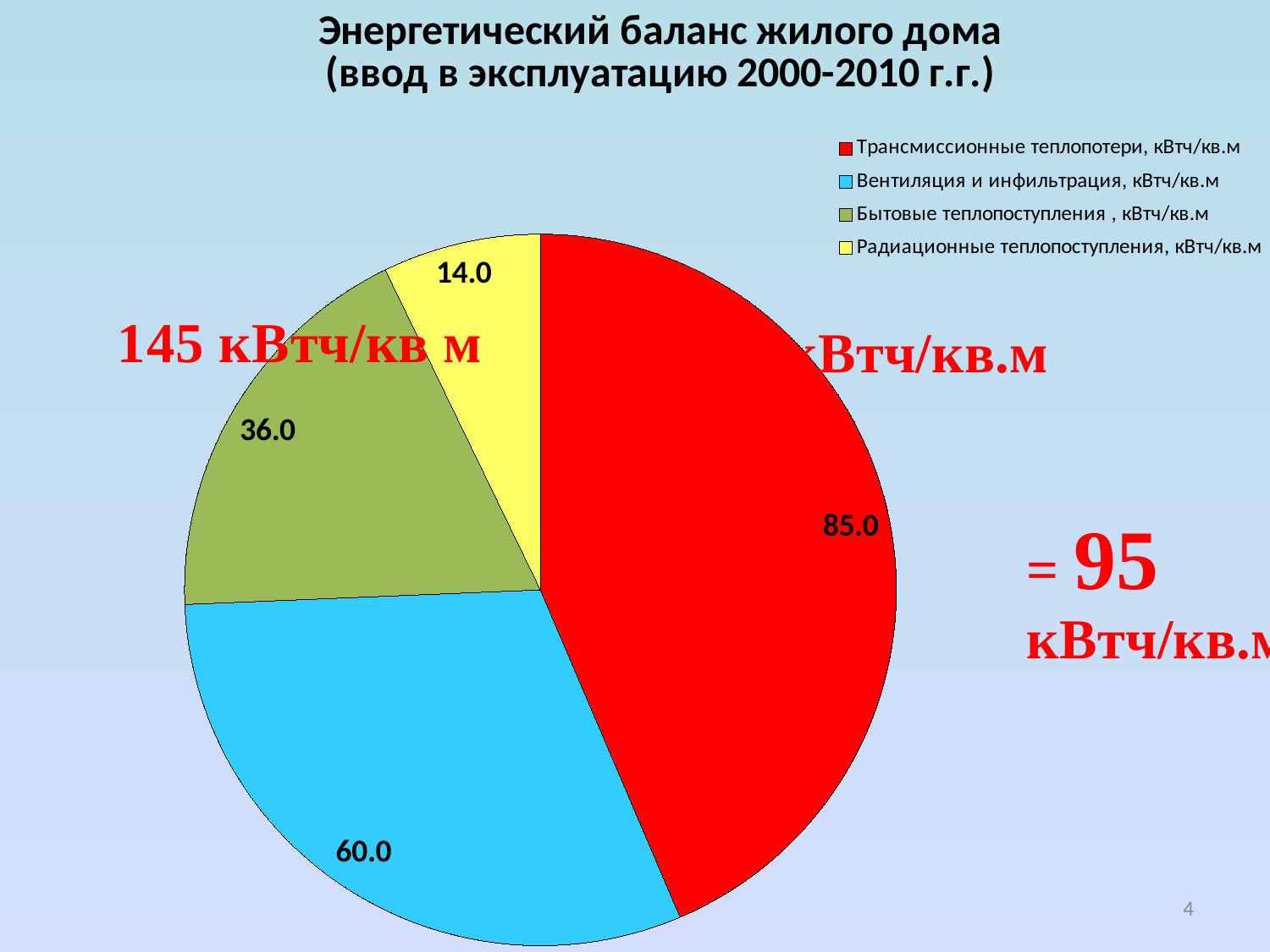
What colour is the slice for Вентиляция и инфильтрация? Blue What is the value for Вентиляция и инфильтрация? 60.0 Which category has the largest slice of the pie? Трансмиссионные теплопотери How many slices does the pie chart have? 4 What is the value for Трансмиссионные теплопотери? 85.0 Which is larger: Бытовые теплопоступления or Радиационные теплопоступления? Бытовые теплопоступления What is the value for Радиационные теплопоступления? 14.0 Which category has the smallest slice of the pie? Радиационные теплопоступления How many entries does the legend list? 4 What is the difference between the values for Трансмиссионные теплопотери and Вентиляция и инфильтрация? 25.0 What kind of chart is shown on the slide? Pie chart What is the value for Бытовые теплопоступления? 36.0